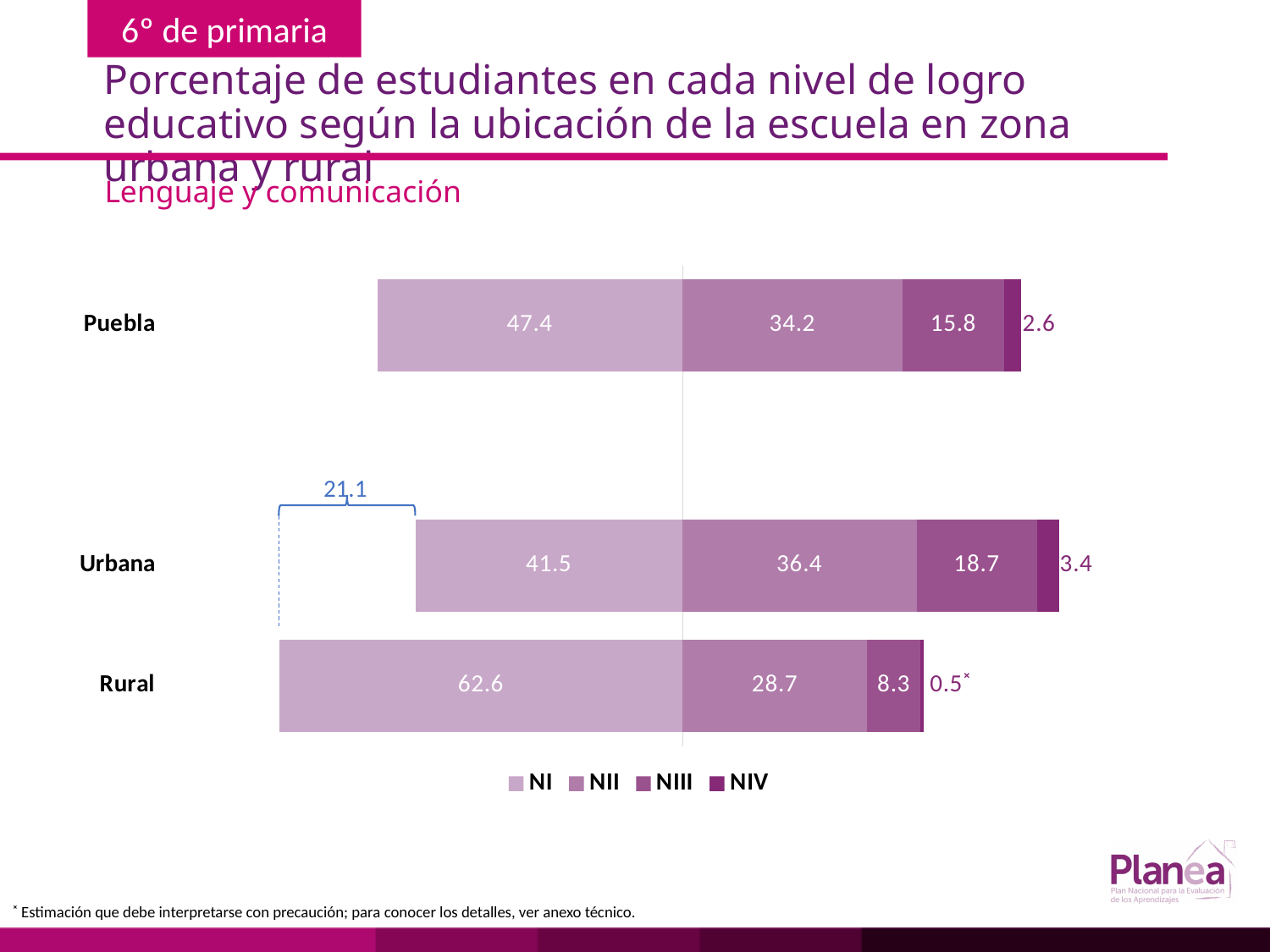
Which category has the highest NI value? Rural What percentage of Rural students are at level NI? 62.6 Which category has the lowest NIV value? Rural How many series does the legend list? 4 What kind of chart is shown on the slide? Stacked bar chart What is the NIV value for Puebla? 2.6 How many categories are shown on the chart? 3 What is the value for NIII in Urbana? 18.7 Which is larger, the NII value for Urbana or the NII value for Puebla? Urbana Which value on the chart is marked with an asterisk as an estimate to be interpreted with caution? 0.5 (Rural NIV) What is the difference between the NIII values for Urbana and Rural? 10.4 What is the difference between the NI values for Rural and Urbana? 21.1